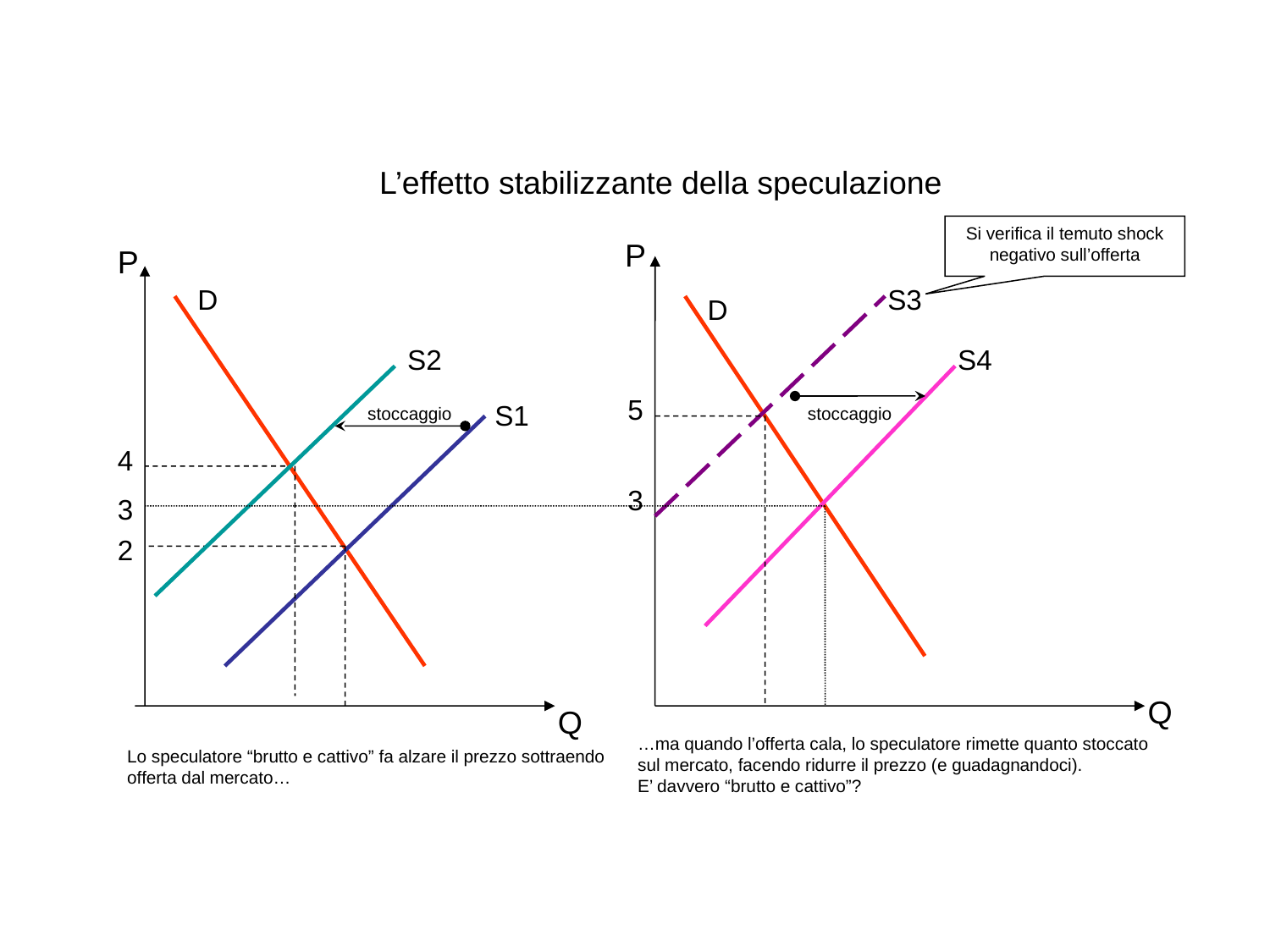
In the right chart, which supply curve gives the lower equilibrium price, S3 or S4? S4 What is the title of the slide containing the two charts? L'effetto stabilizzante della speculazione In the right chart, what is the difference between the equilibrium price with S3 and the equilibrium price with S4? 2 In the left chart, what is the equilibrium price where the demand curve D meets the supply curve S2? 4 In the right chart, what is the equilibrium price where the demand curve D meets the supply curve S4? 3 In the right chart, does the demand curve D rise or fall as Q increases? fall In the left chart, which supply curve gives the higher equilibrium price, S1 or S2? S2 In the right chart, what is the equilibrium price where the demand curve D meets the dashed supply curve S3? 5 How many supply curves are drawn in the left chart? 2 In the right chart, which supply curve is drawn as a dashed line? S3 In the left chart, what is the equilibrium price where the demand curve D meets the supply curve S1? 2 In the left chart, what is the difference between the equilibrium price with S2 and the equilibrium price with S1? 2